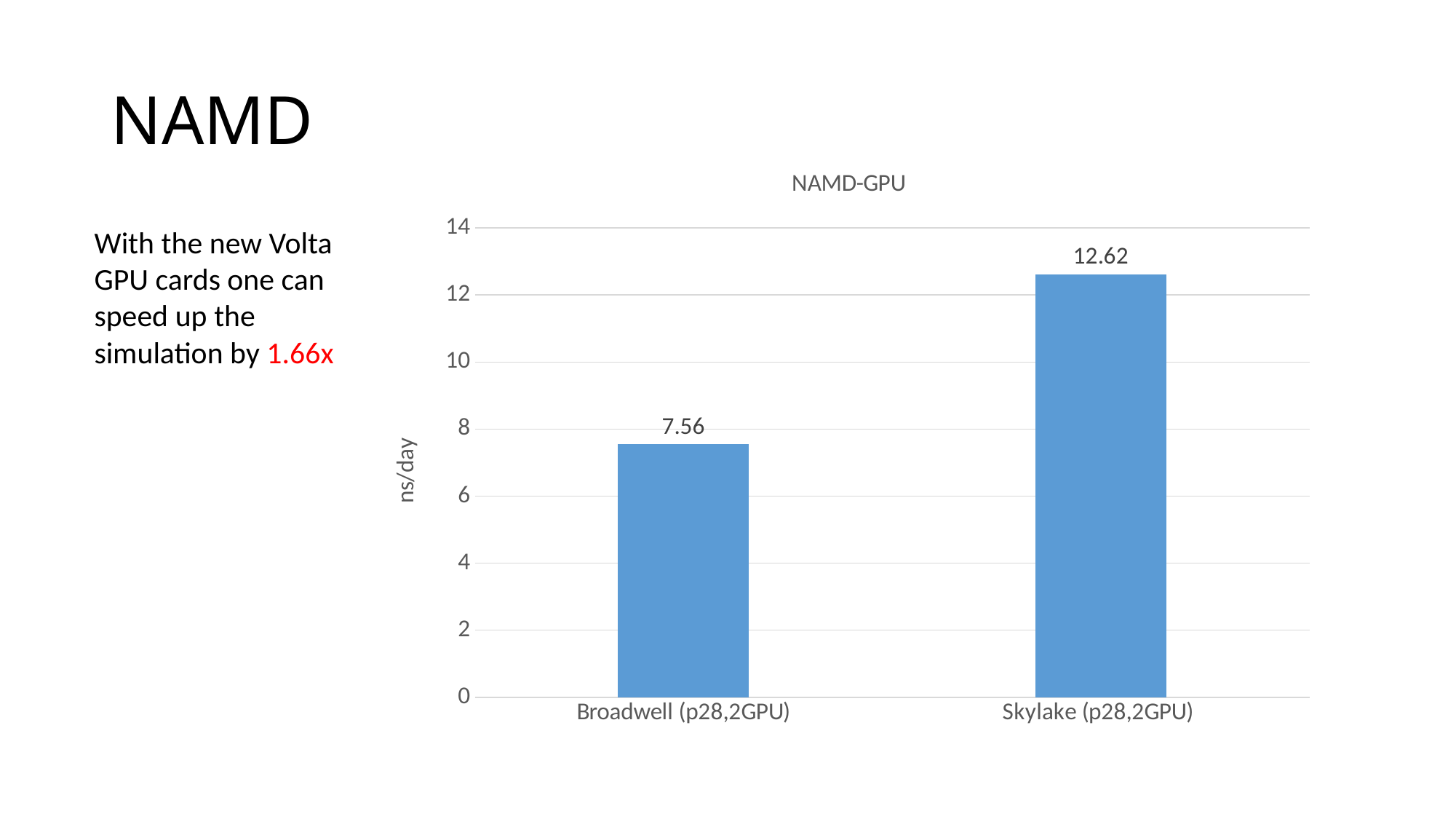
What is the value for Skylake (p28,2GPU)? 12.62 Which category has the highest value? Skylake (p28,2GPU) What kind of chart is shown on the slide? bar chart What is the difference between the values for Skylake (p28,2GPU) and Broadwell (p28,2GPU)? 5.06 What is the title of the chart? NAMD-GPU Which category has the lowest value? Broadwell (p28,2GPU) What is the value for Broadwell (p28,2GPU)? 7.56 Is the value for Broadwell (p28,2GPU) greater or less than 8? less Is the value for Skylake (p28,2GPU) greater or less than 10? greater How many categories are shown on the x axis? 2 Which is larger, the value for Broadwell (p28,2GPU) or Skylake (p28,2GPU)? Skylake (p28,2GPU) What is the label of the y axis? ns/day